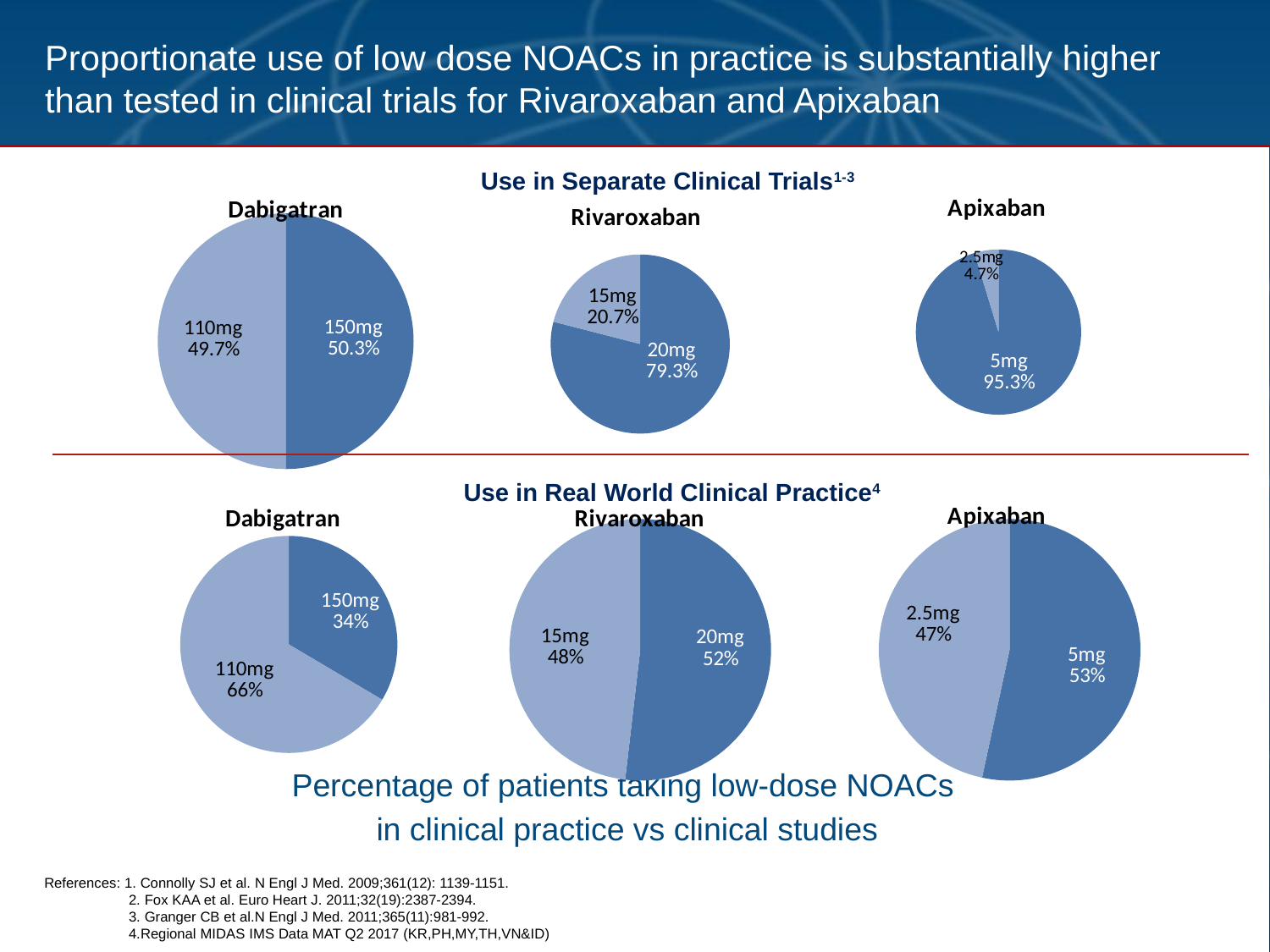
In the Apixaban pie chart under Use in Separate Clinical Trials, what percentage is shown for 5mg? 95.3% In the Dabigatran pie chart under Use in Real World Clinical Practice, what is the difference between the 110mg and 150mg shares? 32% In the Apixaban pie chart under Use in Separate Clinical Trials, which dose has the smallest share? 2.5mg How many slices does the Apixaban pie chart under Use in Real World Clinical Practice have? 2 In the Dabigatran pie chart under Use in Separate Clinical Trials, what percentage is shown for 150mg? 50.3% In the Rivaroxaban pie chart under Use in Separate Clinical Trials, what percentage is shown for 15mg? 20.7% In the Dabigatran pie chart under Use in Real World Clinical Practice, what percentage is shown for 110mg? 66% In the Apixaban pie chart under Use in Real World Clinical Practice, what percentage is shown for 2.5mg? 47% In the Rivaroxaban pie chart under Use in Real World Clinical Practice, which dose has the larger share, 15mg or 20mg? 20mg In the Rivaroxaban pie chart under Use in Separate Clinical Trials, what is the difference between the 20mg and 15mg shares? 58.6% How many pie charts are shown on the slide in total? 6 What type of chart is used for Dabigatran under Use in Separate Clinical Trials? Pie chart